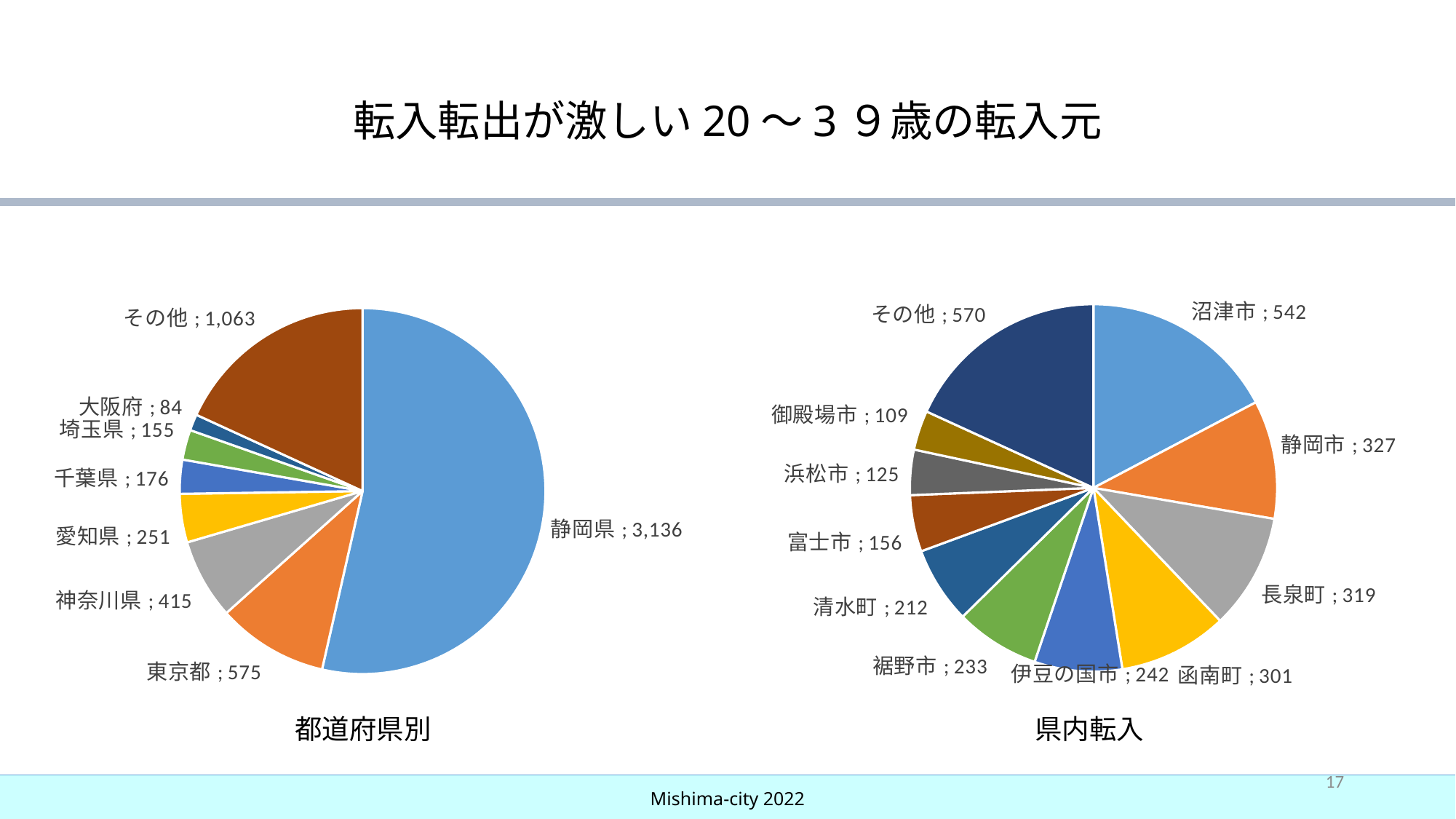
In the 県内転入 chart, what is the value for 沼津市? 542 In the 県内転入 chart, how many slices does the pie have? 11 In the 都道府県別 chart, what is the value for 東京都? 575 In the 県内転入 chart, what is the difference between 裾野市 and 清水町? 21 In the 都道府県別 chart, what is the value for 静岡県? 3,136 In the 県内転入 chart, which category has the smallest value? 御殿場市 In the 都道府県別 chart, which named prefecture (excluding その他) has the smallest value? 大阪府 In the 都道府県別 chart, how many slices does the pie have? 8 What type of charts are shown on the slide? Pie charts In the 都道府県別 chart, what is the difference between 神奈川県 and 愛知県? 164 In the 県内転入 chart, which is larger, 静岡市 or 長泉町? 静岡市 In the 県内転入 chart, what is the value for 函南町? 301